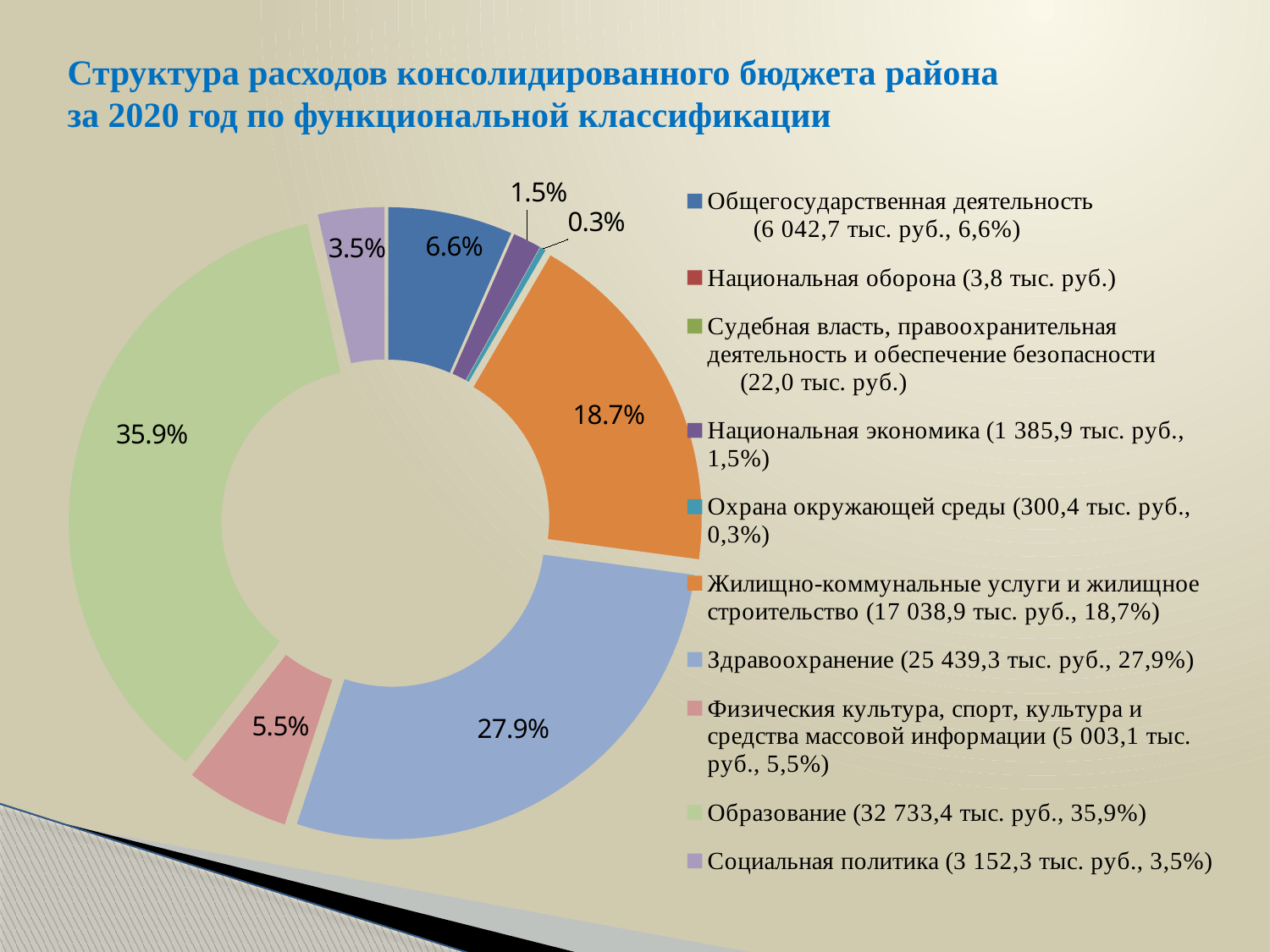
What share of expenditure does the chart show for Здравоохранение? 27.9% By how many percentage points does the Образование share exceed the Здравоохранение share? 8.0% What kind of chart is shown on the slide? pie chart (doughnut) What share does the chart show for Жилищно-коммунальные услуги и жилищное строительство? 18.7% What colour is the Образование slice? light green Which slice is larger: Здравоохранение or Жилищно-коммунальные услуги и жилищное строительство? Здравоохранение How many categories does the legend list? 10 Which category has the largest slice of the chart? Образование What share does the chart show for Национальная экономика? 1.5% What share does the chart show for Социальная политика? 3.5% What share of expenditure does the chart show for Образование? 35.9% What share does the chart show for Охрана окружающей среды? 0.3%